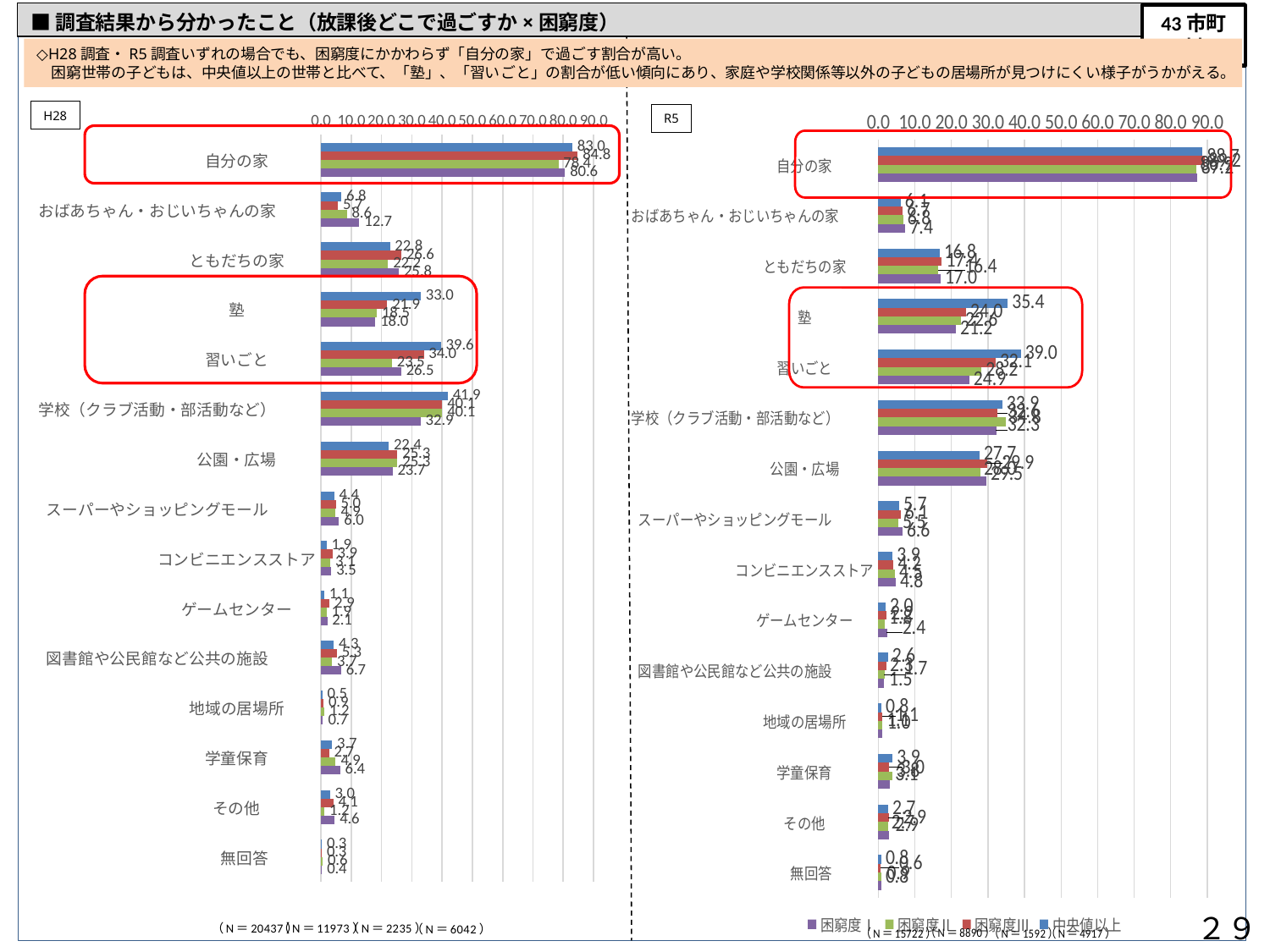
In the H28 chart (left), which is larger for 中央値以上: the value for 習いごと or the value for 塾? 習いごと In the R5 chart (right), what is the difference between the 中央値以上 value and the 困窮度Ⅰ value for 習いごと? 14.1 How many series does the legend list for the charts on this slide? 4 In the H28 chart (left), what is the difference between the 中央値以上 value and the 困窮度Ⅰ value for 塾? 15.0 In the H28 chart (left), what is the value for 中央値以上 in the 塾 category? 33.0 How many categories are shown on the y axis of the R5 chart (right)? 15 In the H28 chart (left), what is the value for 困窮度Ⅰ in the 自分の家 category? 80.6 In the R5 chart (right), what is the value for 困窮度Ⅰ in the 塾 category? 21.2 What kind of chart is the H28 chart (left)? bar chart In the R5 chart (right), what is the value for 中央値以上 in the 習いごと category? 39.0 In the H28 chart (left), which category has the highest values across all series? 自分の家 In the R5 chart (right), is the 中央値以上 value for 自分の家 greater or less than 80.0? greater